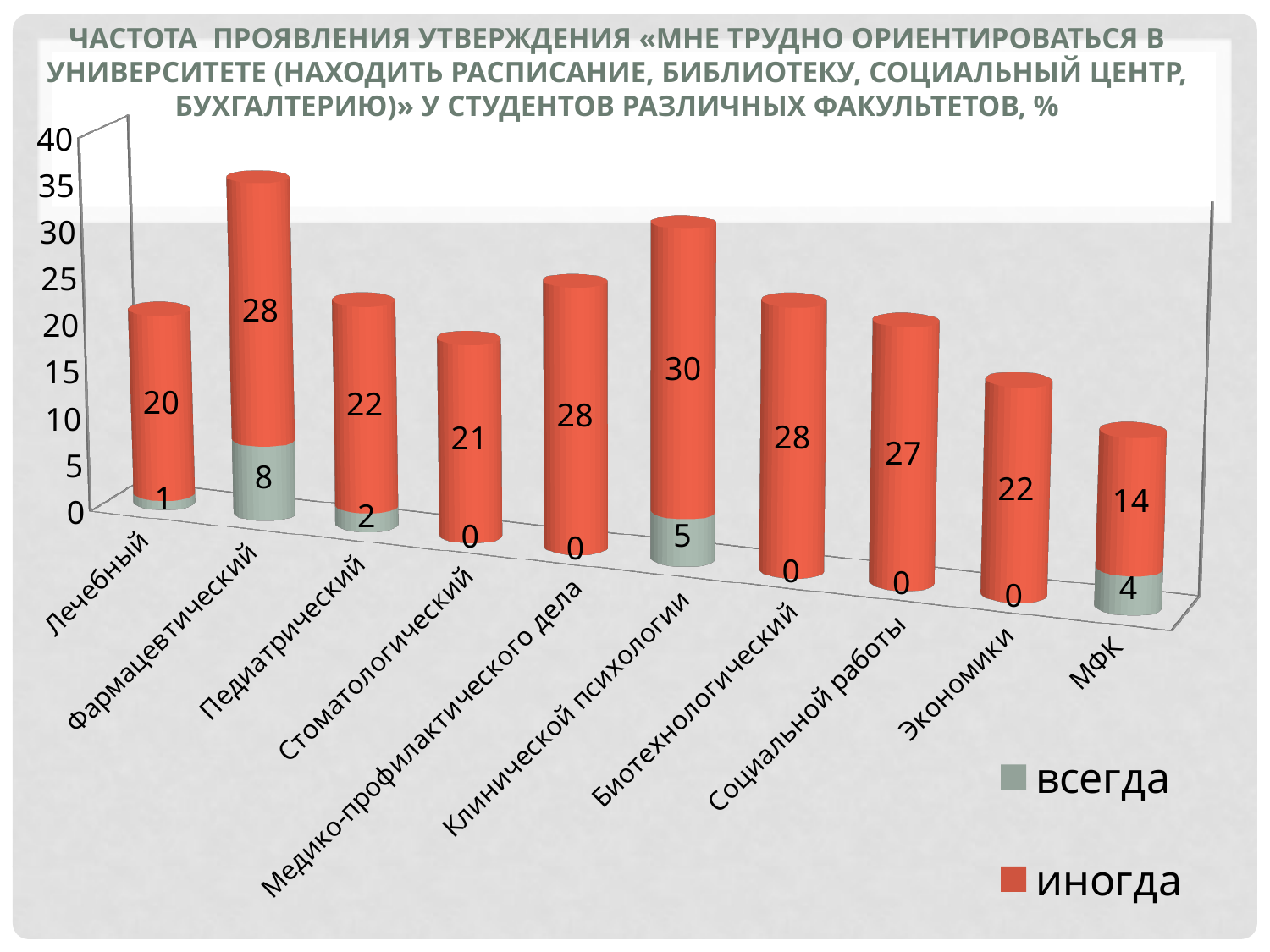
What is the value of «всегда» for Клинической психологии? 5 Which is larger: the «всегда» value for Фармацевтический or for МФК? Фармацевтический How many series does the legend list? 2 What is the difference between the «иногда» values for Клинической психологии and Лечебный? 10 What is the value of «иногда» for МФК? 14 Which faculty has the highest value for «иногда»? Клинической психологии What is the total of the stacked bar for Фармацевтический? 36 What is the value of «иногда» for Фармацевтический? 28 How many faculties are shown on the chart? 10 What kind of chart is shown on the slide? Stacked bar chart Which faculty has the highest value for «всегда»? Фармацевтический Which faculty has the lowest value for «иногда»? МФК